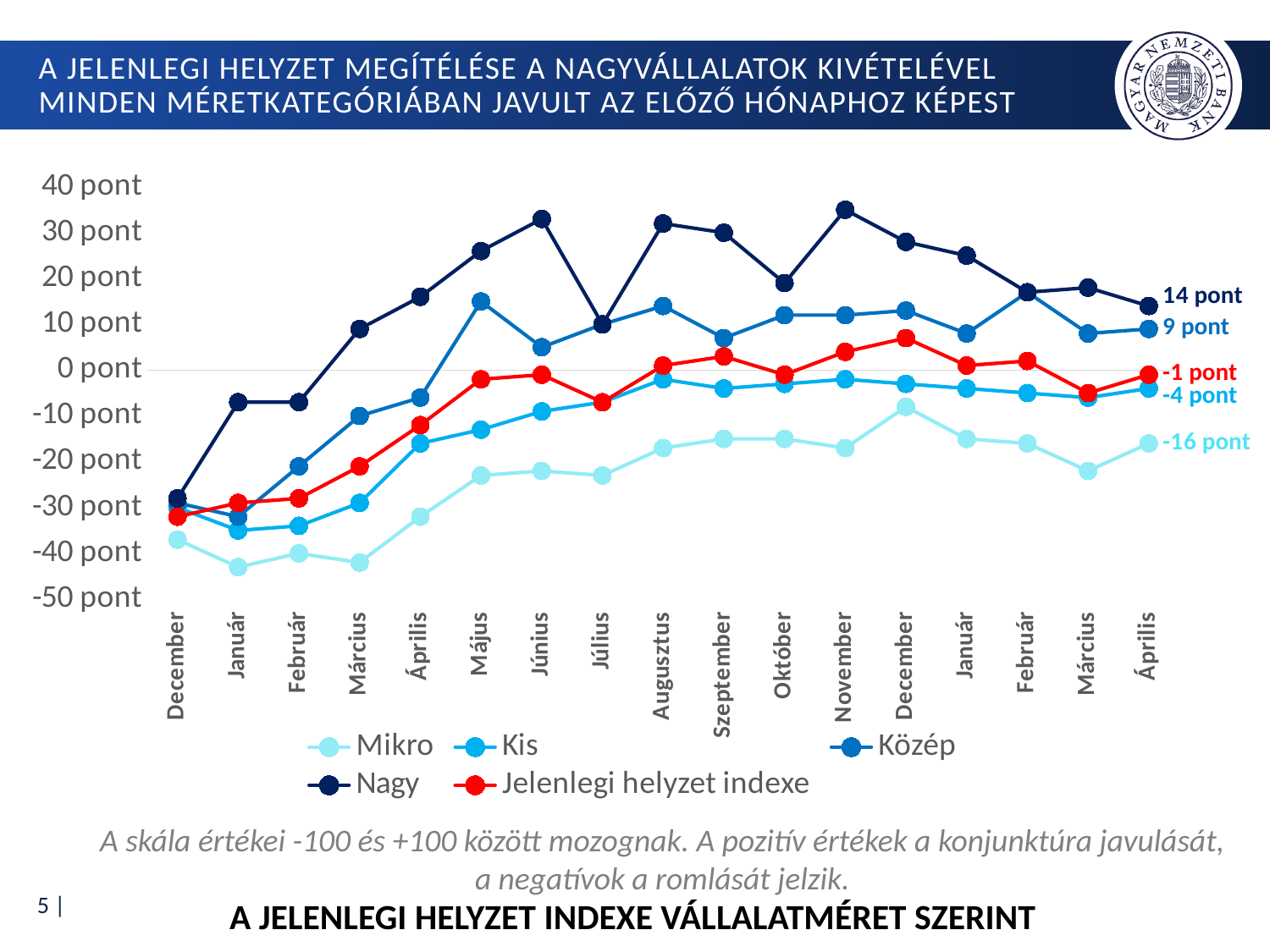
What is the value of the Mikro series in the final Április? -16 pont How many series does the legend list? 5 How many months are shown along the x axis? 17 What is the value of the Közép series in the final Április? 9 pont What is the difference between the Nagy and Mikro values in the final Április? 30 pont Which series has the highest value in the final Április? Nagy What is the value of the Nagy series in the final Április? 14 pont What kind of chart is shown on the slide? line chart What is the value of the Jelenlegi helyzet indexe series in the final Április? -1 pont In the final Április, which is larger: the Közép value or the Kis value? Közép What is the title of the chart shown at the bottom of the slide? A JELENLEGI HELYZET INDEXE VÁLLALATMÉRET SZERINT Is the value for Nagy in November greater or less than 30 pont? greater